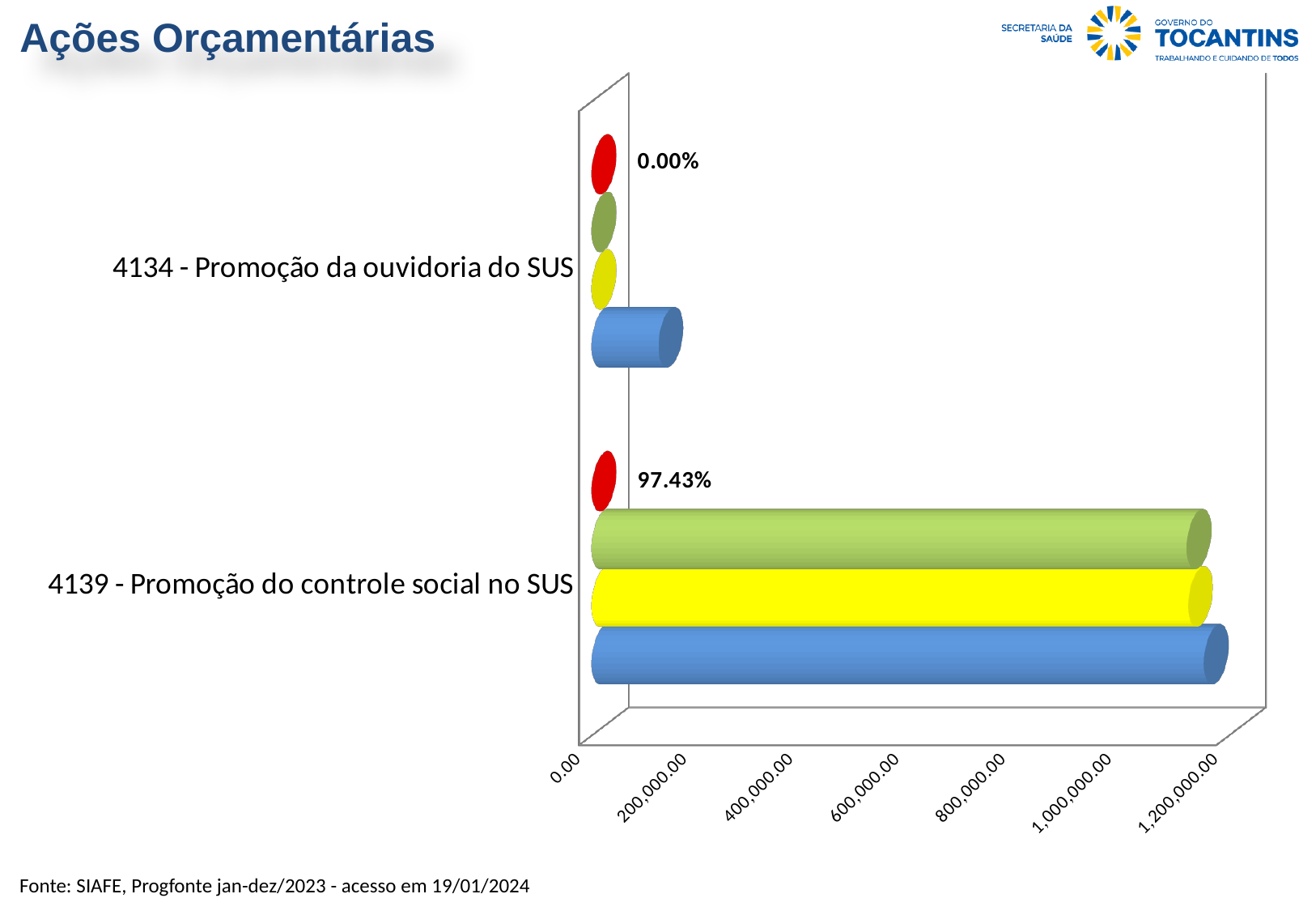
Which category has the longest bars on the chart? 4139 - Promoção do controle social no SUS Is the value of the blue bar for '4134 - Promoção da ouvidoria do SUS' greater or less than 200,000.00? less What is the title of the slide containing the chart? Ações Orçamentárias How many budget actions (categories) are plotted on the chart? 2 What kind of chart is shown on the slide? bar chart Is the value of the green bar for '4139 - Promoção do controle social no SUS' greater or less than 800,000.00? greater What is the highest tick value shown on the horizontal axis? 1,200,000.00 Which category has the higher percentage label, 4134 or 4139? 4139 - Promoção do controle social no SUS What percentage is labelled for '4134 - Promoção da ouvidoria do SUS'? 0.00% What is the difference between the percentage labels of 4139 and 4134? 97.43% What percentage is labelled for '4139 - Promoção do controle social no SUS'? 97.43% Is the value of the blue bar for '4139 - Promoção do controle social no SUS' greater or less than 1,000,000.00? greater